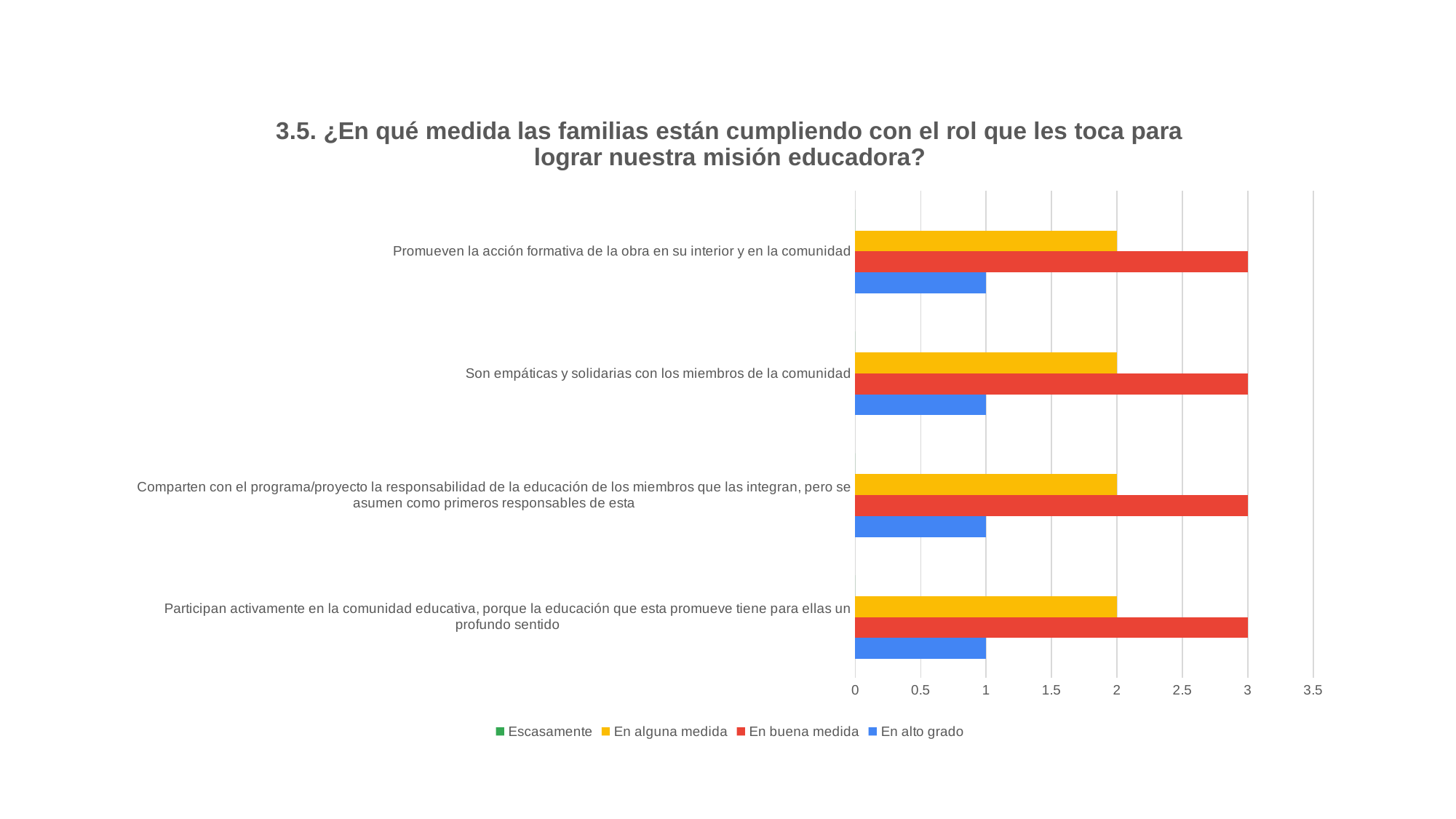
Which legend entry is shown in red? En buena medida Is the value of 'En buena medida' for 'Son empáticas y solidarias con los miembros de la comunidad' greater or less than 2.5? greater What kind of chart is shown on the slide? bar chart Which is larger for 'Participan activamente en la comunidad educativa, porque la educación que esta promueve tiene para ellas un profundo sentido': 'En alguna medida' or 'En alto grado'? En alguna medida What is the value of 'En buena medida' for 'Son empáticas y solidarias con los miembros de la comunidad'? 3 How many categories are plotted on the chart? 4 What is the value of 'En alguna medida' for 'Promueven la acción formativa de la obra en su interior y en la comunidad'? 2 Which series has the lowest visible bar for 'Son empáticas y solidarias con los miembros de la comunidad'? En alto grado Which series has the highest value for 'Comparten con el programa/proyecto la responsabilidad de la educación de los miembros que las integran, pero se asumen como primeros responsables de esta'? En buena medida What is the value of 'En alto grado' for 'Participan activamente en la comunidad educativa, porque la educación que esta promueve tiene para ellas un profundo sentido'? 1 What is the difference between 'En buena medida' and 'En alto grado' for 'Promueven la acción formativa de la obra en su interior y en la comunidad'? 2 How many series does the legend list? 4